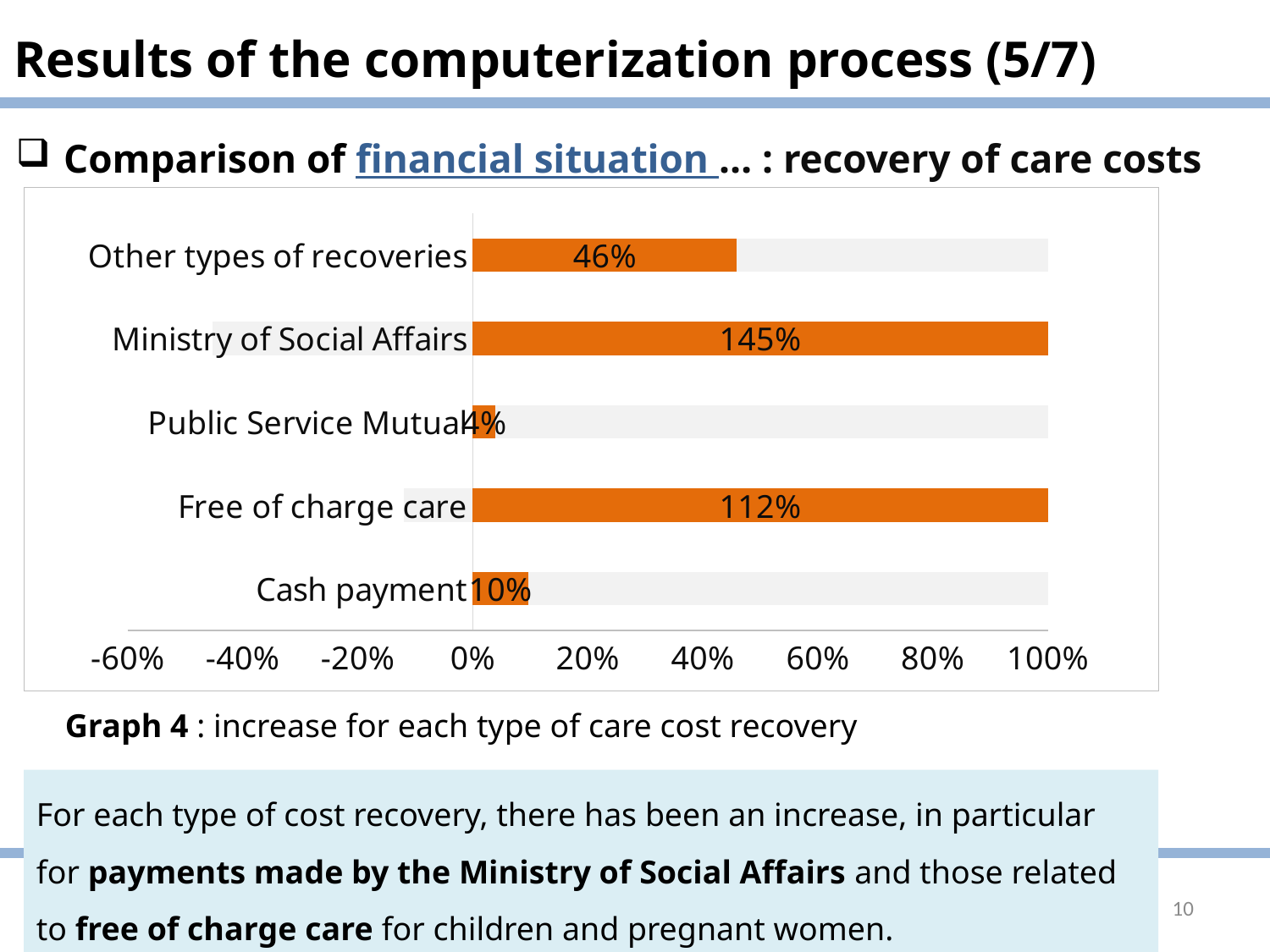
Which is larger, the value for Other types of recoveries or the value for Cash payment? Other types of recoveries What is the caption given for the chart below it? Graph 4 : increase for each type of care cost recovery What is the value for Free of charge care? 112% What is the value for Other types of recoveries? 46% Which category has the highest value? Ministry of Social Affairs What is the value for Cash payment? 10% What kind of chart is shown on the slide? Bar chart How many categories are shown in the chart? 5 Which category has the lowest value? Public Service Mutual What is the value for Ministry of Social Affairs? 145% What is the value for Public Service Mutual? 4% What is the difference between the values for Ministry of Social Affairs and Free of charge care? 33%